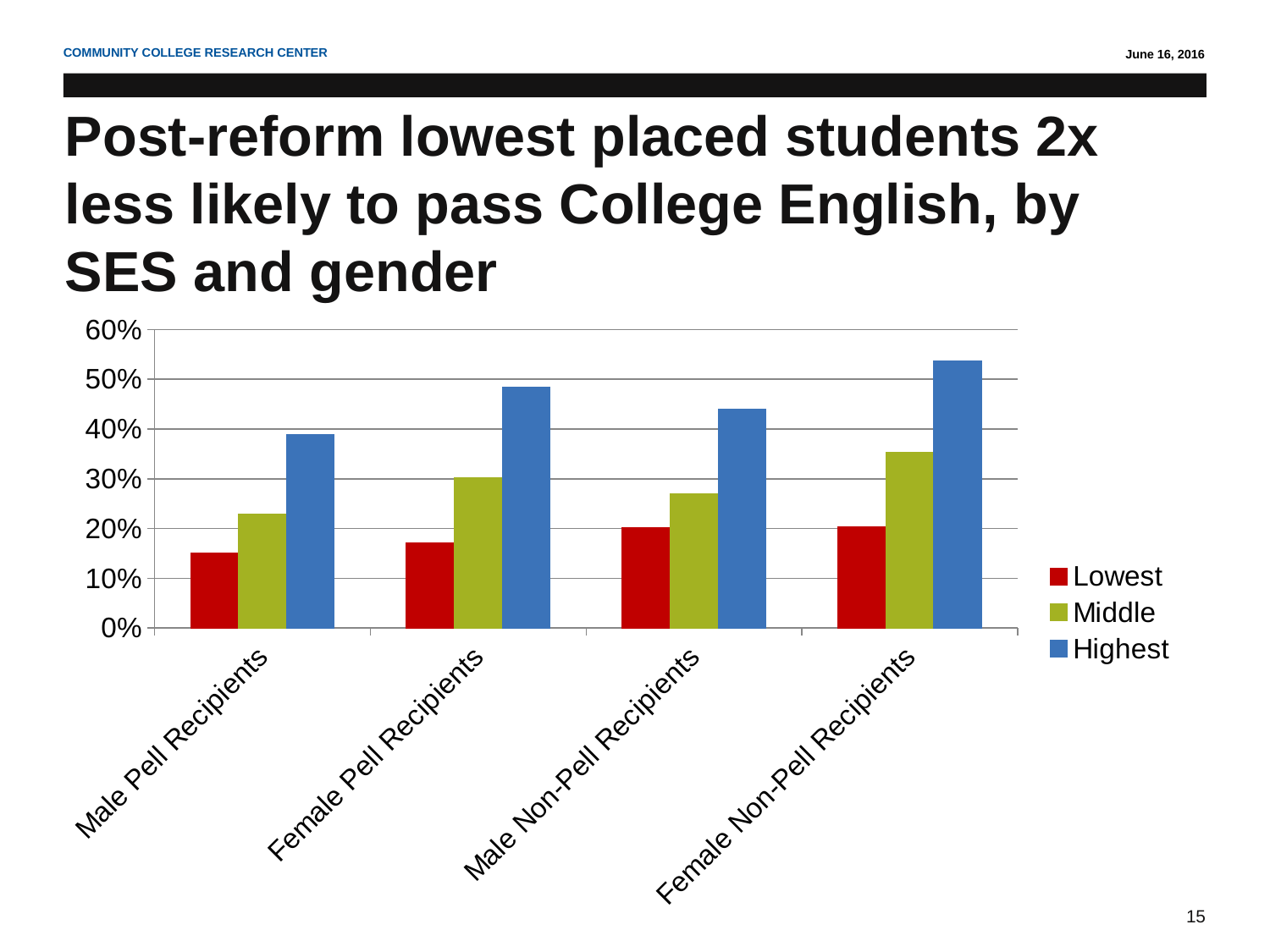
Which is larger: the Highest value for Female Pell Recipients or the Highest value for Male Non-Pell Recipients? Female Pell Recipients Is the Highest value for Male Non-Pell Recipients greater or less than 40%? greater Which category has the tallest Highest bar? Female Non-Pell Recipients Which category has the shortest Lowest bar? Male Pell Recipients Is the Middle value for Male Pell Recipients greater or less than 30%? less Is the Highest value for Female Non-Pell Recipients greater or less than 50%? greater Which colour represents the Highest series in the legend? blue What kind of chart is shown on the slide? bar chart How many categories are shown along the x axis? 4 How many series does the legend list? 3